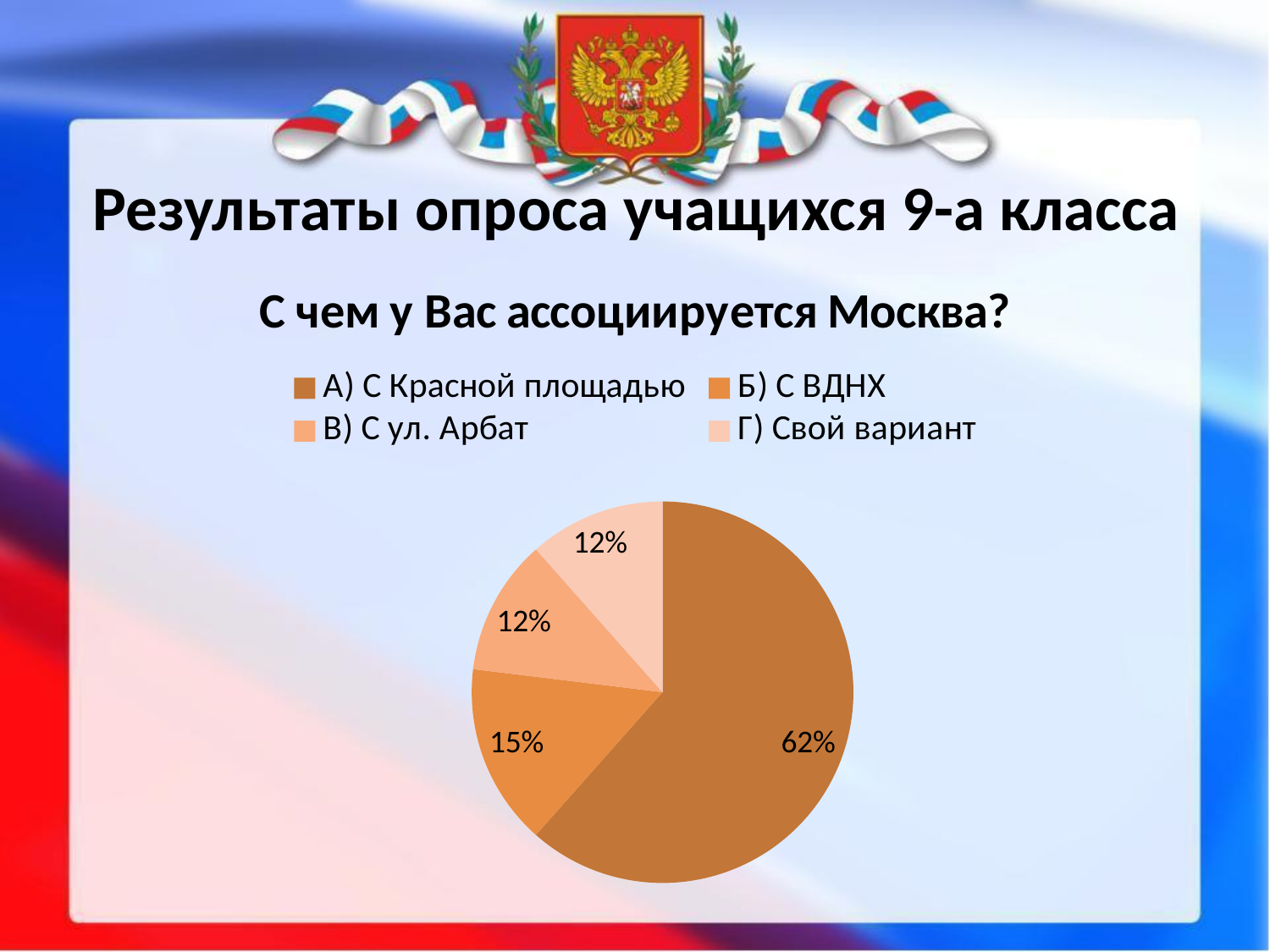
Which answer option has the largest share of the pie? А) С Красной площадью What is the difference in percentage points between "А) С Красной площадью" and "Б) С ВДНХ"? 47 What is the difference in percentage points between "Б) С ВДНХ" and "В) С ул. Арбат"? 3 What percentage of students chose "А) С Красной площадью"? 62% Which has a larger share: "Б) С ВДНХ" or "Г) Свой вариант"? Б) С ВДНХ What is the title of the chart? С чем у Вас ассоциируется Москва? What percentage of students chose "Б) С ВДНХ"? 15% What percentage of students chose "Г) Свой вариант"? 12% How many slices does the pie chart have? 4 How many entries does the chart legend list? 4 What type of chart is shown on the slide? pie chart What percentage of students chose "В) С ул. Арбат"? 12%